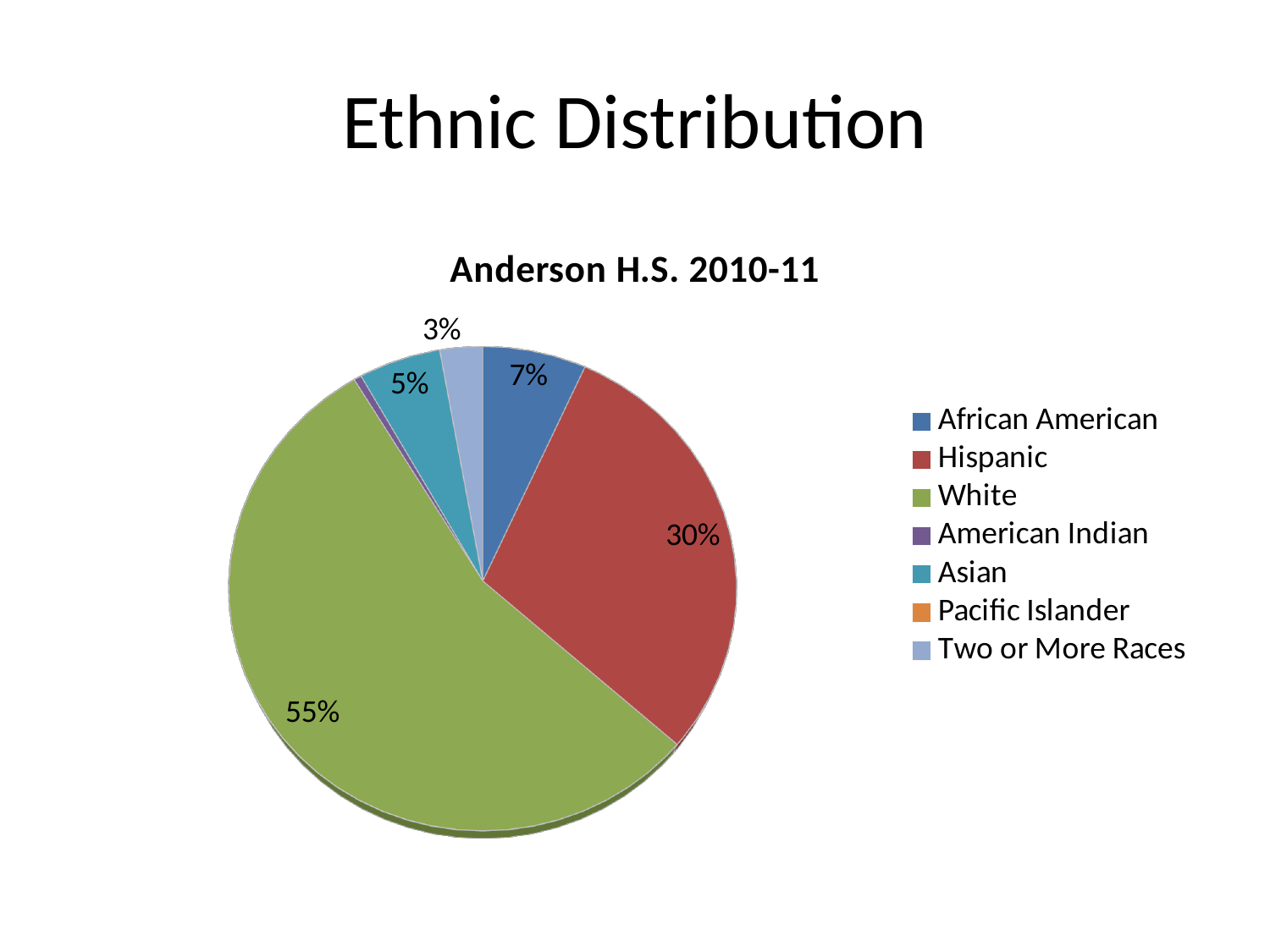
What percentage of the pie is Hispanic? 30% What percentage of the pie is White? 55% What is the difference between the White share and the Hispanic share? 25% What kind of chart is shown on the slide? Pie chart Which category has the largest share of the pie? White What is the title of the chart? Anderson H.S. 2010-11 What is the difference between the Asian share and the Two or More Races share? 2% Which is larger, the Hispanic share or the African American share? Hispanic What percentage of the pie is Two or More Races? 3% How many categories does the legend list? 7 What percentage of the pie is Asian? 5% What percentage of the pie is African American? 7%